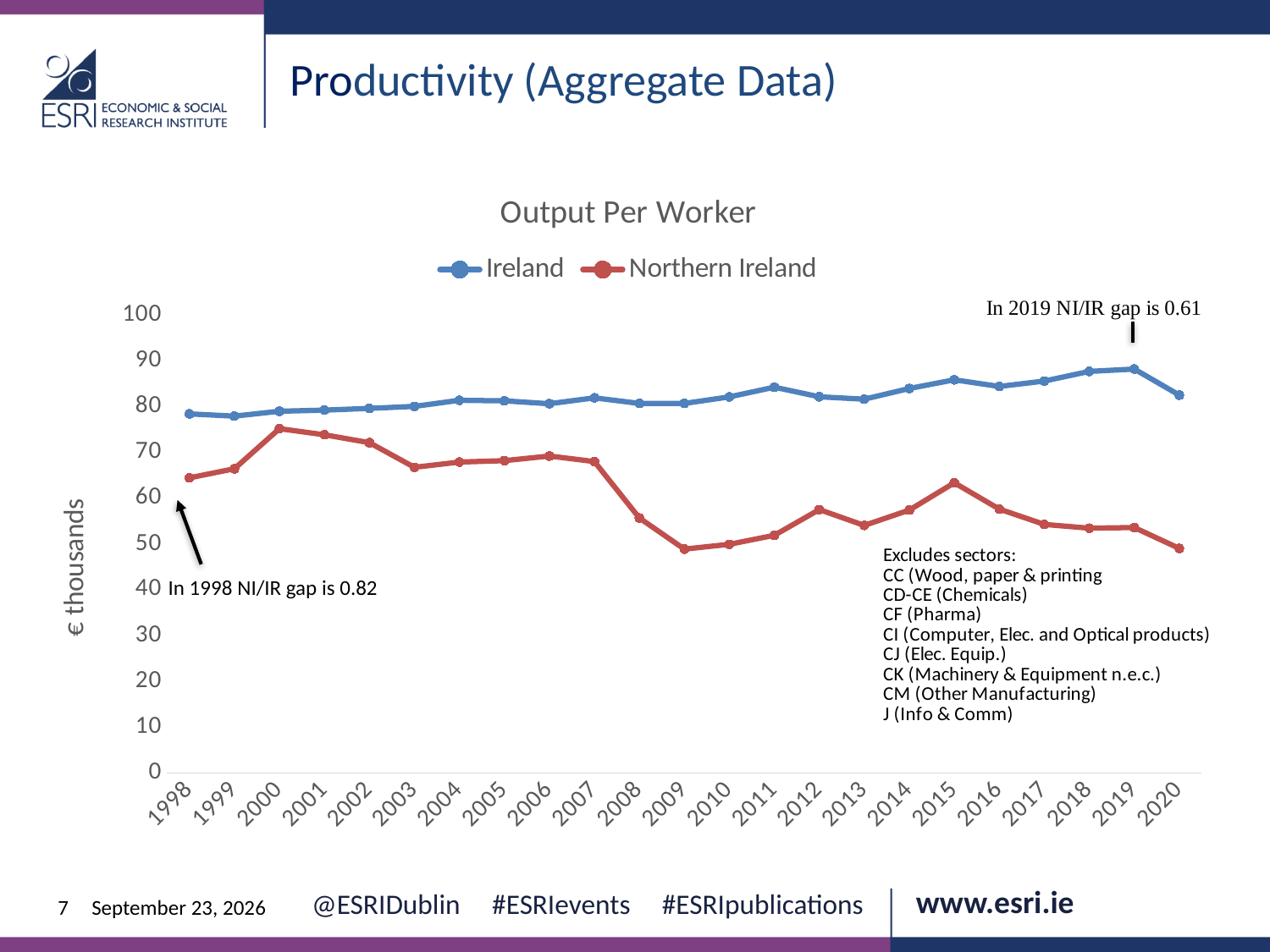
What kind of chart is shown on the slide? Line chart Is the value for Ireland in 1998 greater or less than 80? less Is the value for Northern Ireland in 2020 greater or less than 60? less What is the title of the chart? Output Per Worker Is the value for Northern Ireland in 2000 greater or less than 70? greater How many years are plotted along the x axis? 23 According to the annotation on the chart, what is the NI/IR gap in 2019? 0.61 In which year is the Northern Ireland series at its highest? 2000 Does the Northern Ireland series rise or fall between 2015 and 2020? Fall How many series does the legend list? 2 In 2010, which series has the larger value, Ireland or Northern Ireland? Ireland